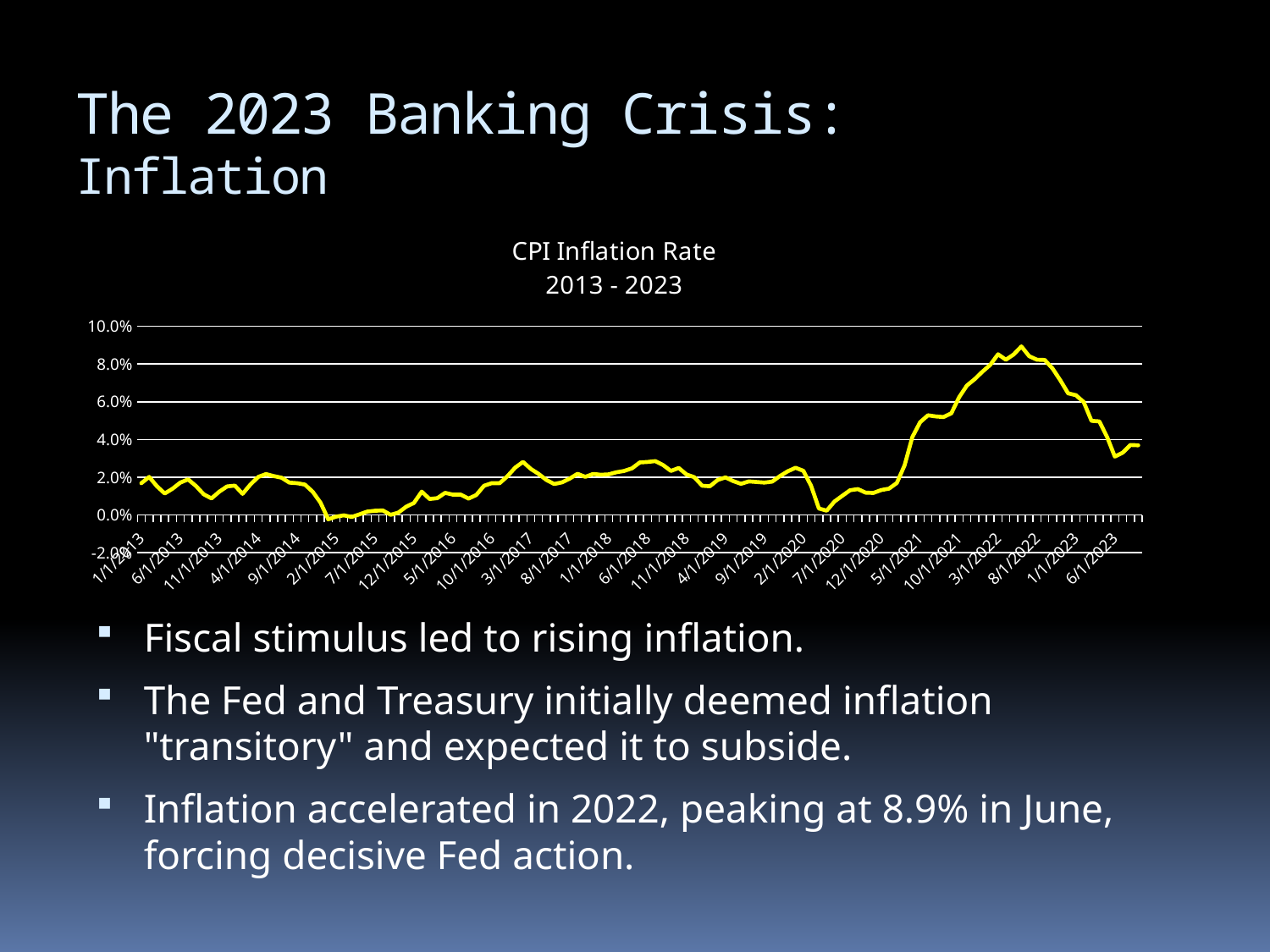
Does the CPI inflation rate rise or fall between 12/1/2020 and 3/1/2022? rise How many lines (data series) are plotted on the chart? 1 Which is higher, the CPI inflation rate at 3/1/2022 or at 1/1/2018? 3/1/2022 What is the title of the chart? CPI Inflation Rate 2013 - 2023 What kind of chart is shown on the slide? line chart Does the CPI inflation rate rise or fall between 8/1/2022 and 6/1/2023? fall Is the CPI inflation rate at 3/1/2022 greater or less than 6.0%? greater Is the CPI inflation rate at 6/1/2023 greater or less than 4.0%? less In which year does the line reach its highest point? 2022 Is the CPI inflation rate at 7/1/2020 greater or less than 2.0%? less